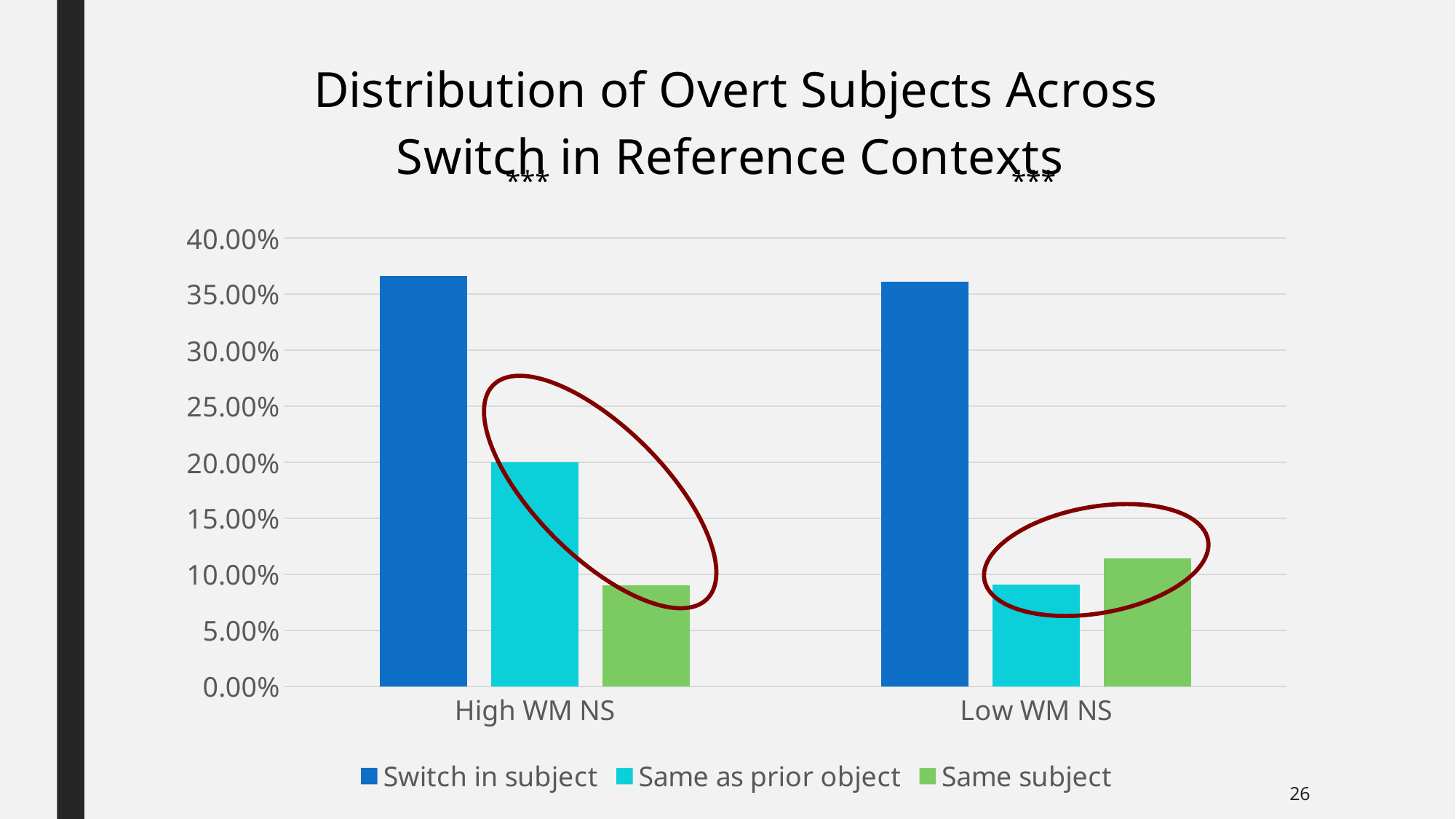
Which series has the highest value for High WM NS? Switch in subject Which is larger for Low WM NS: Same as prior object or Same subject? Same subject Which series has the lowest value for Low WM NS? Same as prior object What kind of chart is shown on the slide? bar chart Is the value for Same subject in Low WM NS greater or less than 10.00%? greater Is the value for Same subject in High WM NS greater or less than 10.00%? less Which series has the lowest value for High WM NS? Same subject How many categories are shown on the x axis? 2 Is the value for Switch in subject in High WM NS greater or less than 35.00%? greater What is the title of the chart? Distribution of Overt Subjects Across Switch in Reference Contexts Which is larger: Same as prior object for High WM NS or Same as prior object for Low WM NS? High WM NS How many series does the legend list? 3